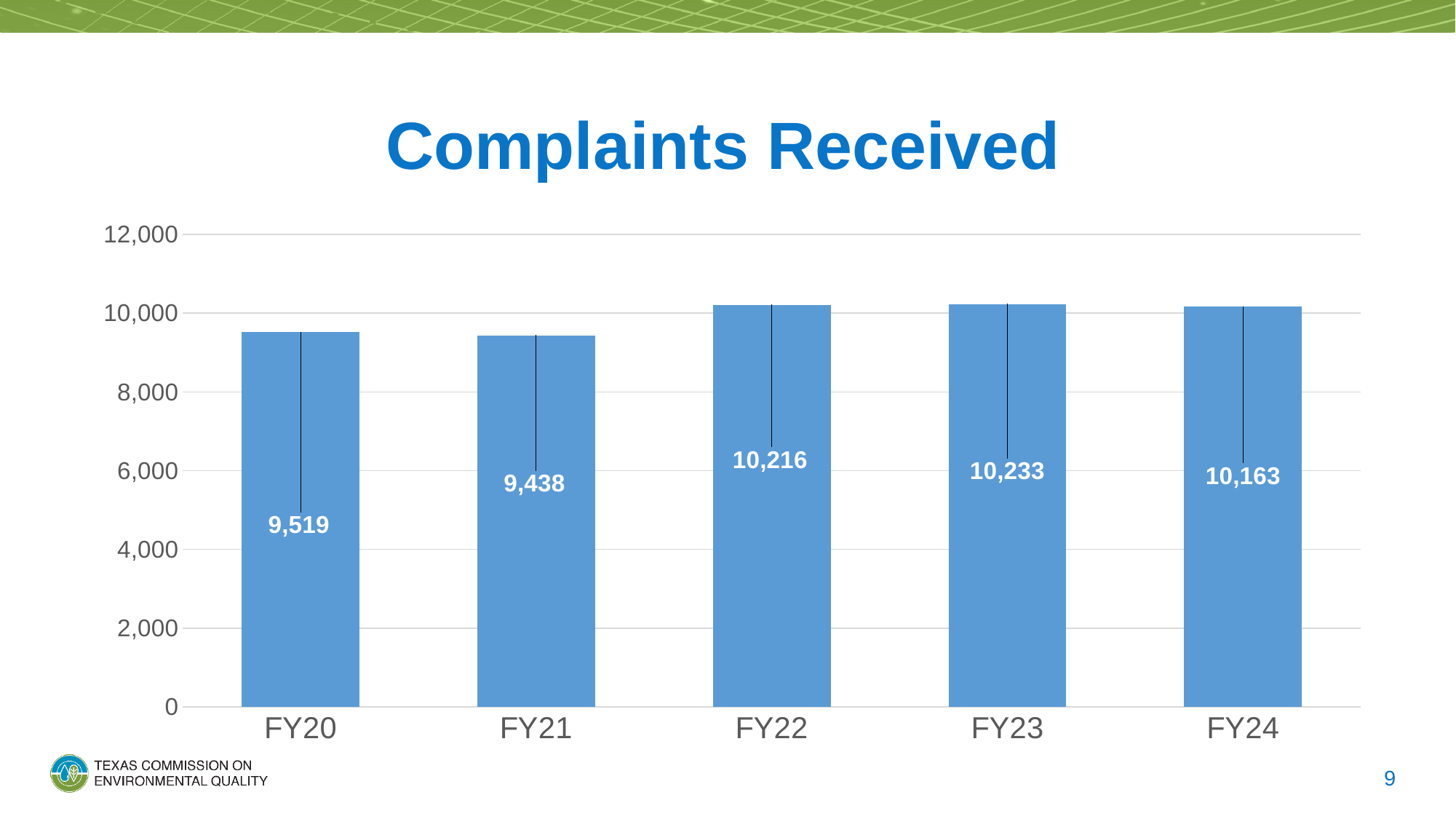
What is the number of complaints received in FY24? 10,163 How many fiscal years are shown on the chart? 5 What is the number of complaints received in FY22? 10,216 Is the value for FY21 greater or less than 10,000? less What is the number of complaints received in FY20? 9,519 What is the difference in complaints received between FY22 and FY20? 697 Which fiscal year had the lowest number of complaints received? FY21 What is the difference in complaints received between FY23 and FY21? 795 What is the number of complaints received in FY21? 9,438 Which fiscal year had the highest number of complaints received? FY23 What type of chart is shown on the slide? bar chart Which year had more complaints received, FY20 or FY24? FY24